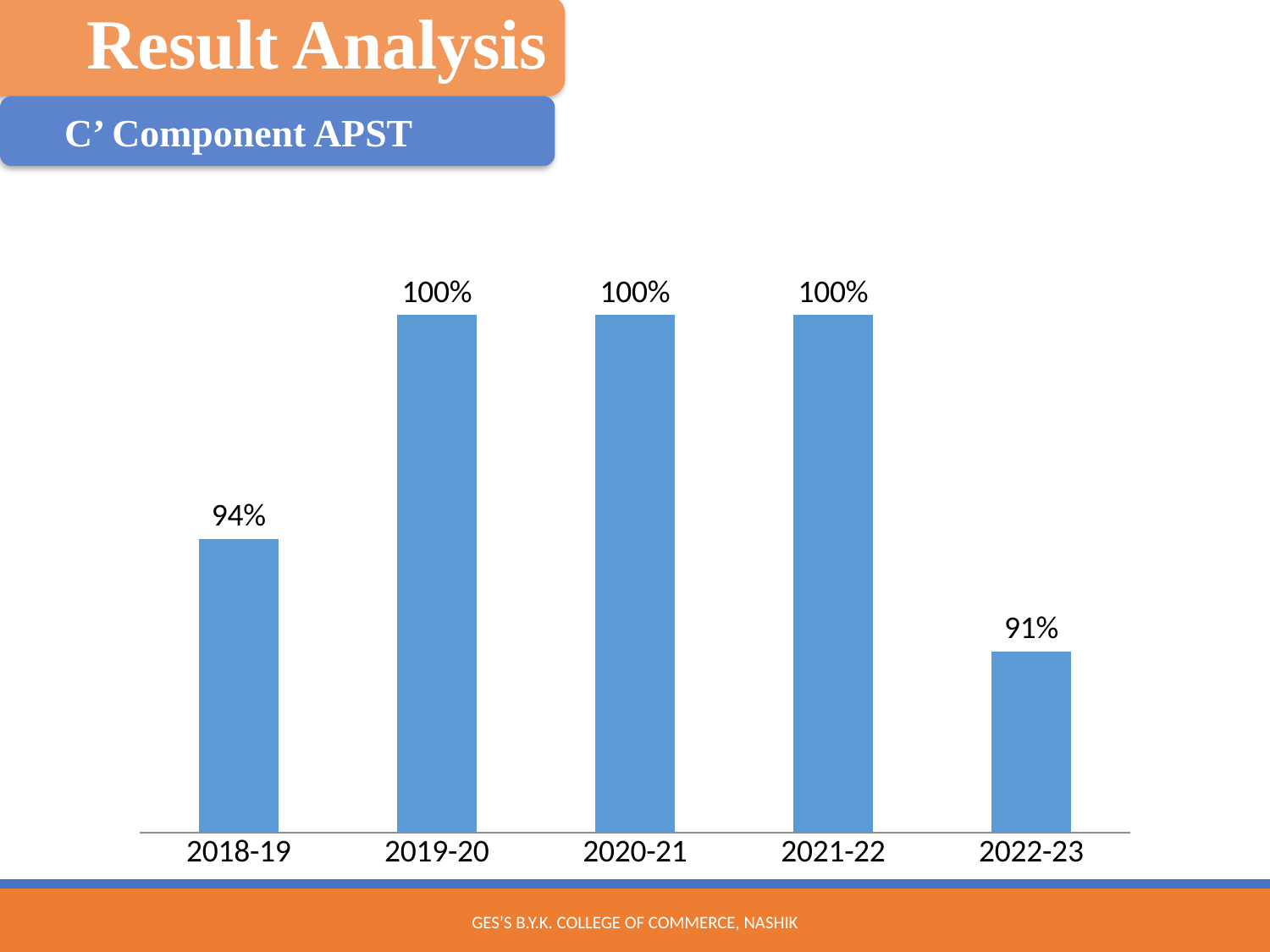
Which is larger, the value for 2021-22 or the value for 2018-19? 2021-22 What is the difference between the values for 2019-20 and 2022-23? 9% Which year has the lowest value? 2022-23 What is the subtitle shown above the chart? C' Component APST What kind of chart is shown on the slide? Bar chart How many years are shown on the x axis? 5 What is the value for 2018-19? 94% What is the difference between the values for 2018-19 and 2022-23? 3% What is the value for 2020-21? 100% Which is larger, the value for 2018-19 or the value for 2022-23? 2018-19 What is the value for 2022-23? 91% How many years have a value of 100%? 3